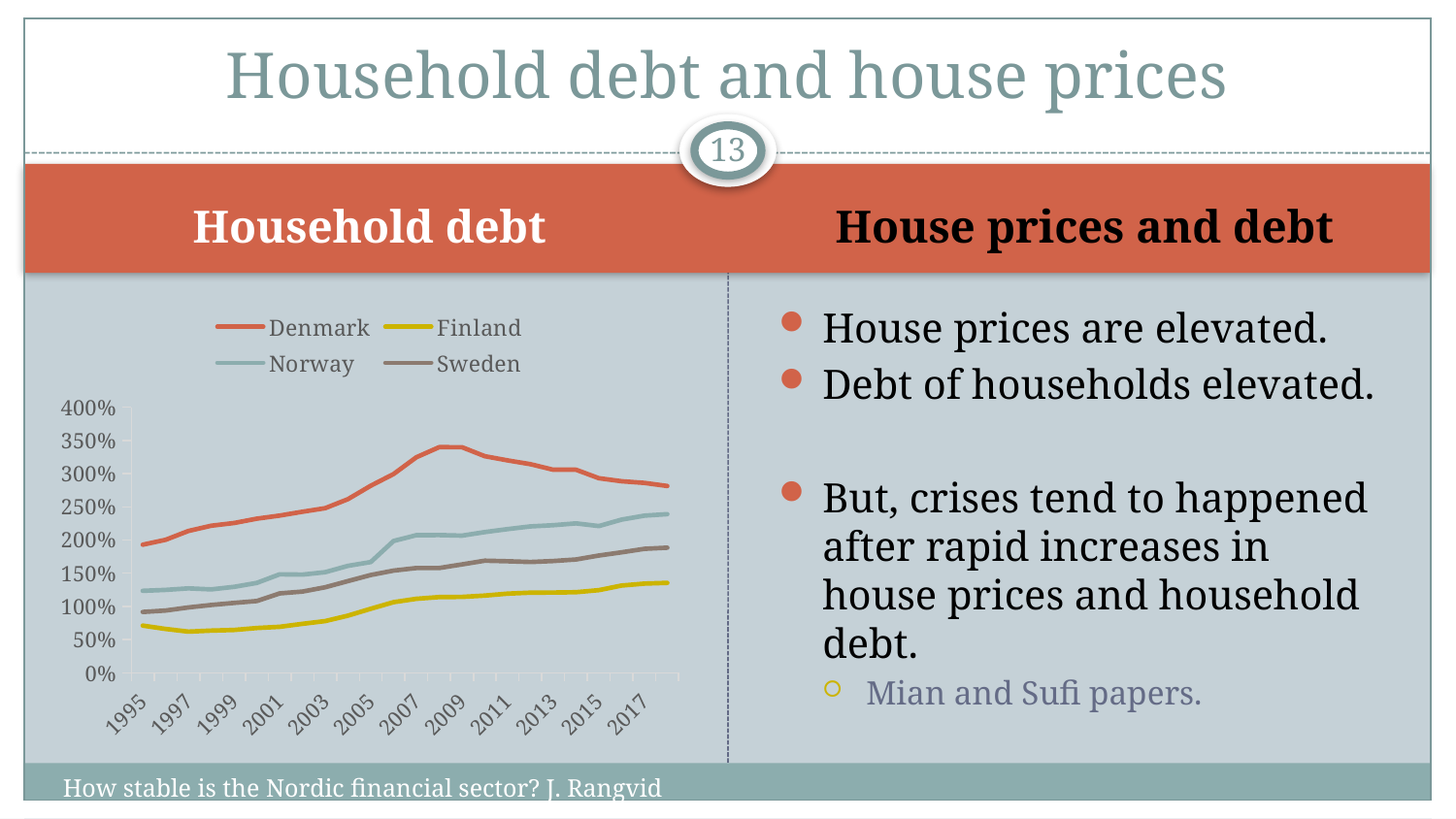
Which country has the highest household debt in 2009 in the chart? Denmark Is the household debt value for Denmark in 2009 greater or less than 300%? greater Is the household debt value for Norway in 2017 greater or less than 200%? greater Which countries are listed in the legend of the household debt chart? Denmark, Finland, Norway, Sweden Is the household debt value for Finland in 1995 greater or less than 100%? less In 2017, which has the larger household debt value in the chart, Norway or Sweden? Norway How many year labels are shown on the x axis of the household debt chart? 12 Which country has the lowest household debt across the whole period shown in the chart? Finland How many series does the legend of the household debt chart list? 4 Does Denmark's household debt rise or fall between 2009 and 2017 in the chart? Fall What type of chart is shown under the 'Household debt' heading? Line chart